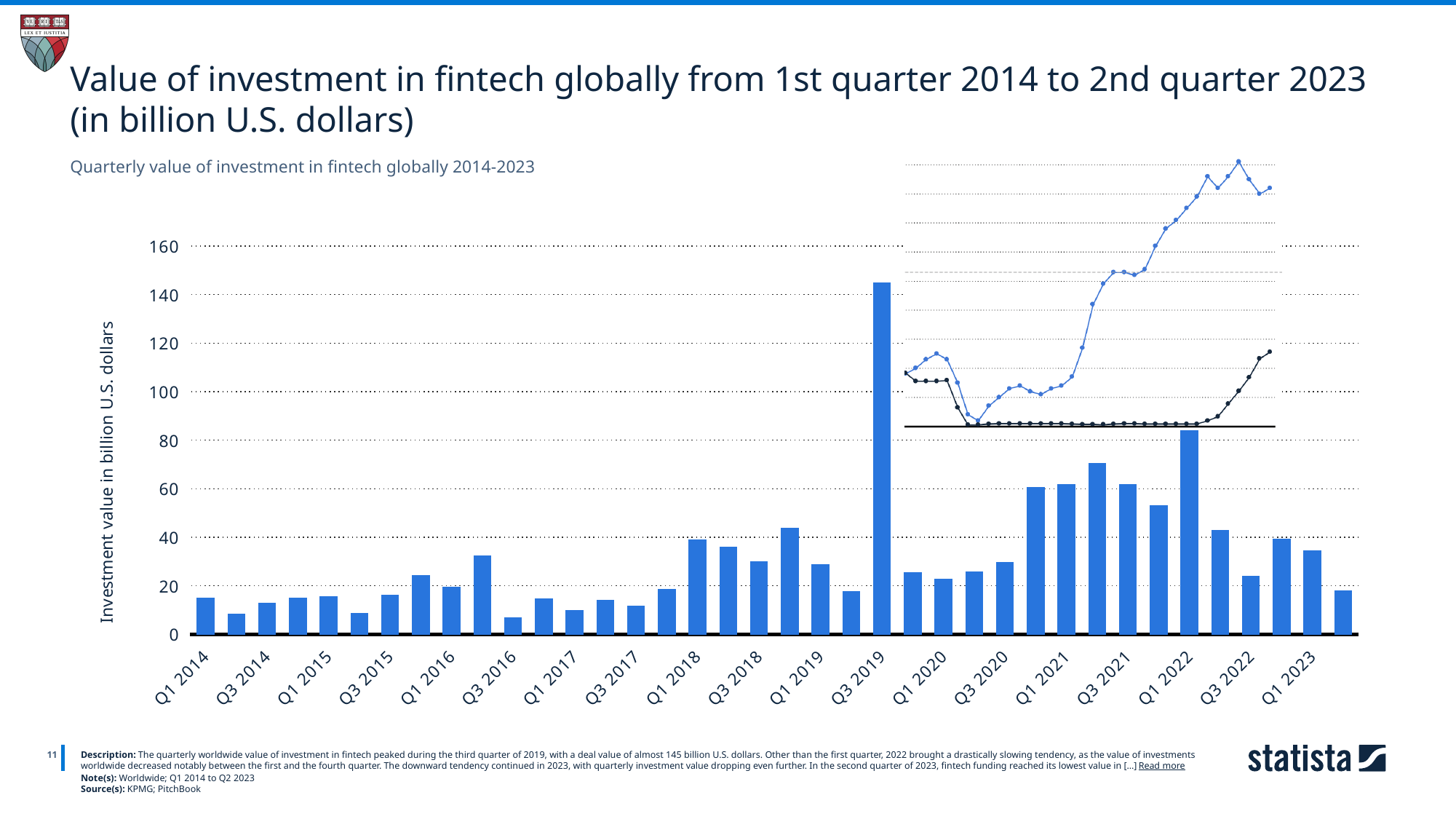
Which is larger, the value for Q1 2021 or the value for Q1 2020? Q1 2021 Which quarter has the highest investment value in the bar chart? Q3 2019 Is the value for Q1 2019 greater or less than 40? less Between Q1 2020 and Q1 2022, do the investment values generally rise or fall? rise Which is larger, the value for Q3 2019 or the value for Q1 2022? Q3 2019 How many quarterly bars are plotted in the chart? 38 Is the value for Q3 2016 greater or less than 20? less What is the label on the vertical axis of the chart? Investment value in billion U.S. dollars Is the value for Q1 2022 greater or less than 80? greater What kind of chart is shown on the slide? bar chart